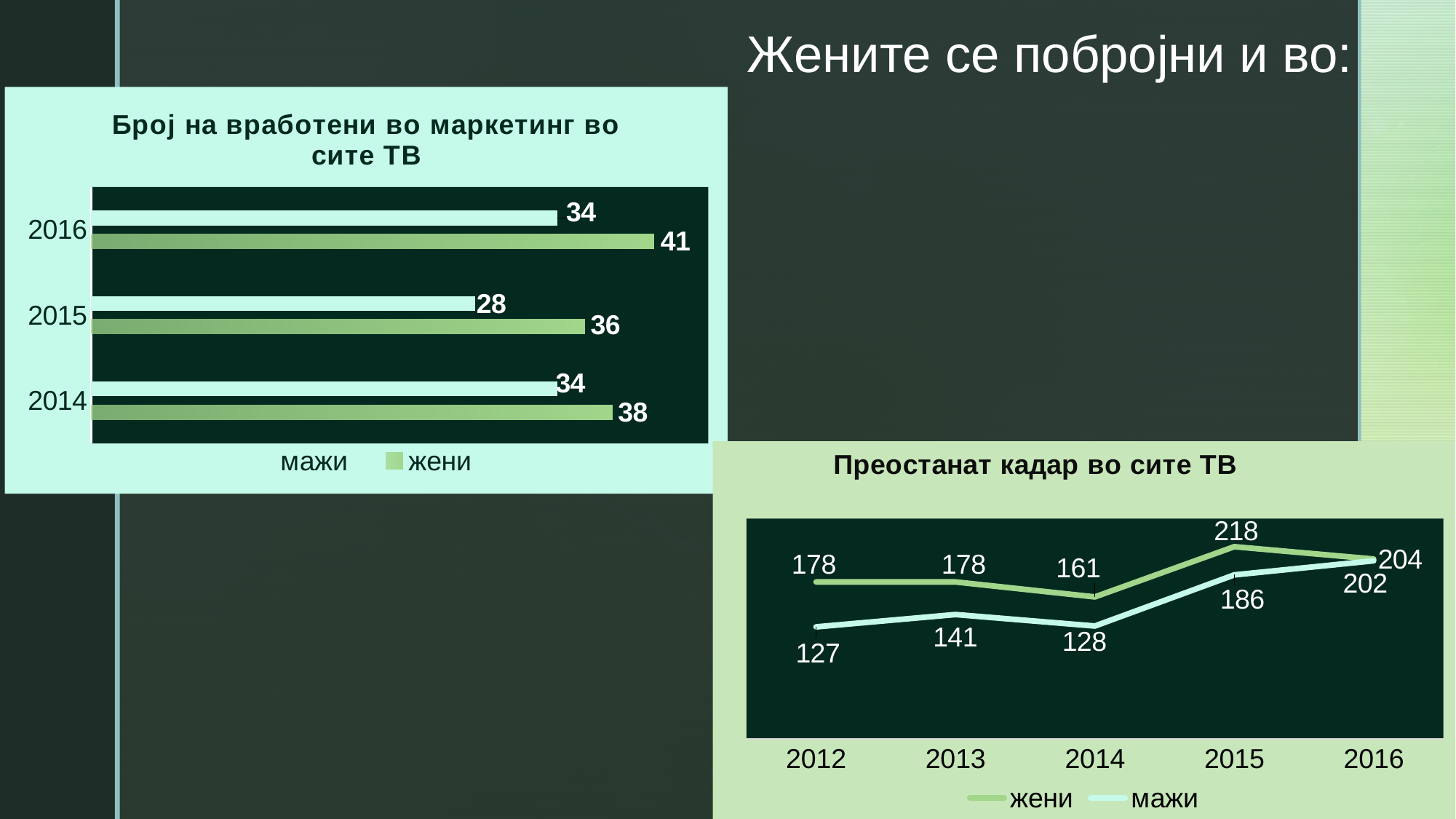
In the chart 'Број на вработени во маркетинг во сите ТВ', what is the difference between жени and мажи in 2015? 8 In the chart 'Број на вработени во маркетинг во сите ТВ', what is the value for мажи in 2015? 28 In the chart 'Преостанат кадар во сите ТВ', what is the value for мажи in 2013? 141 In the chart 'Број на вработени во маркетинг во сите ТВ', what is the value for жени in 2016? 41 In the chart 'Број на вработени во маркетинг во сите ТВ', which year has the highest value for жени? 2016 What kind of chart is 'Преостанат кадар во сите ТВ'? Line chart What kind of chart is 'Број на вработени во маркетинг во сите ТВ'? Bar chart In the chart 'Преостанат кадар во сите ТВ', what is the value for жени in 2015? 218 In the chart 'Преостанат кадар во сите ТВ', which year has the lowest value for мажи? 2012 In the chart 'Преостанат кадар во сите ТВ', how many years are shown on the x axis? 5 How many series does the legend of the chart 'Број на вработени во маркетинг во сите ТВ' list? 2 In the chart 'Преостанат кадар во сите ТВ', what is the difference between жени and мажи in 2014? 33